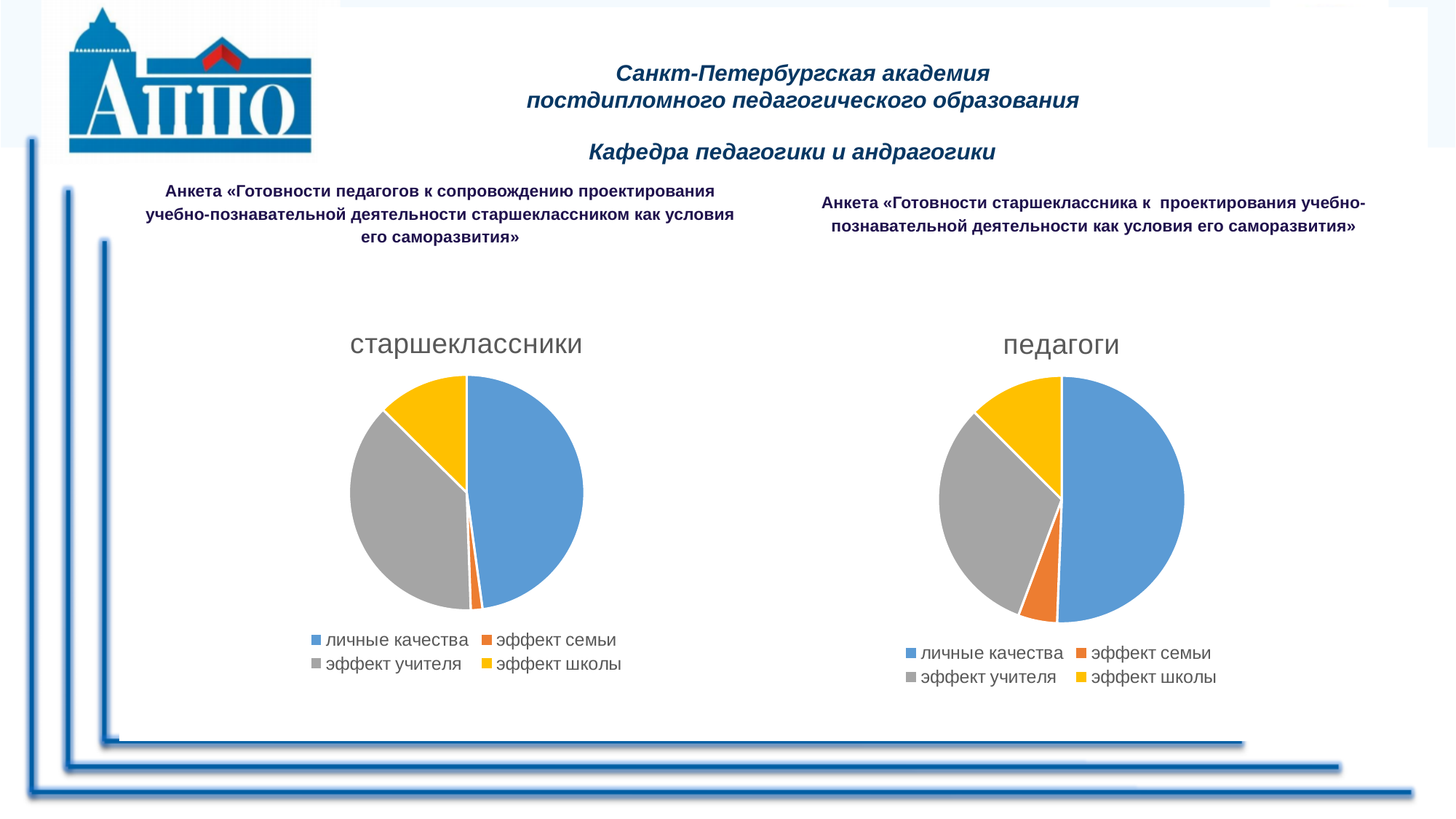
What is the title of the pie chart on the left side of the slide? старшеклассники In the chart titled "старшеклассники", which slice is larger: эффект учителя or эффект школы? эффект учителя What kind of chart is the chart titled "педагоги"? pie chart In the chart titled "старшеклассники", how many slices does the pie have? 4 In the chart titled "педагоги", how many entries does the legend list? 4 What kind of chart is the chart titled "старшеклассники"? pie chart In the chart titled "старшеклассники", which category has the smallest slice? эффект семьи In the chart titled "педагоги", which category has the smallest slice? эффект семьи In the chart titled "педагоги", which category has the largest slice? личные качества In the chart titled "педагоги", which slice is larger: личные качества or эффект учителя? личные качества In the chart titled "педагоги", which colour represents эффект школы? yellow In the chart titled "старшеклассники", which category has the largest slice? личные качества